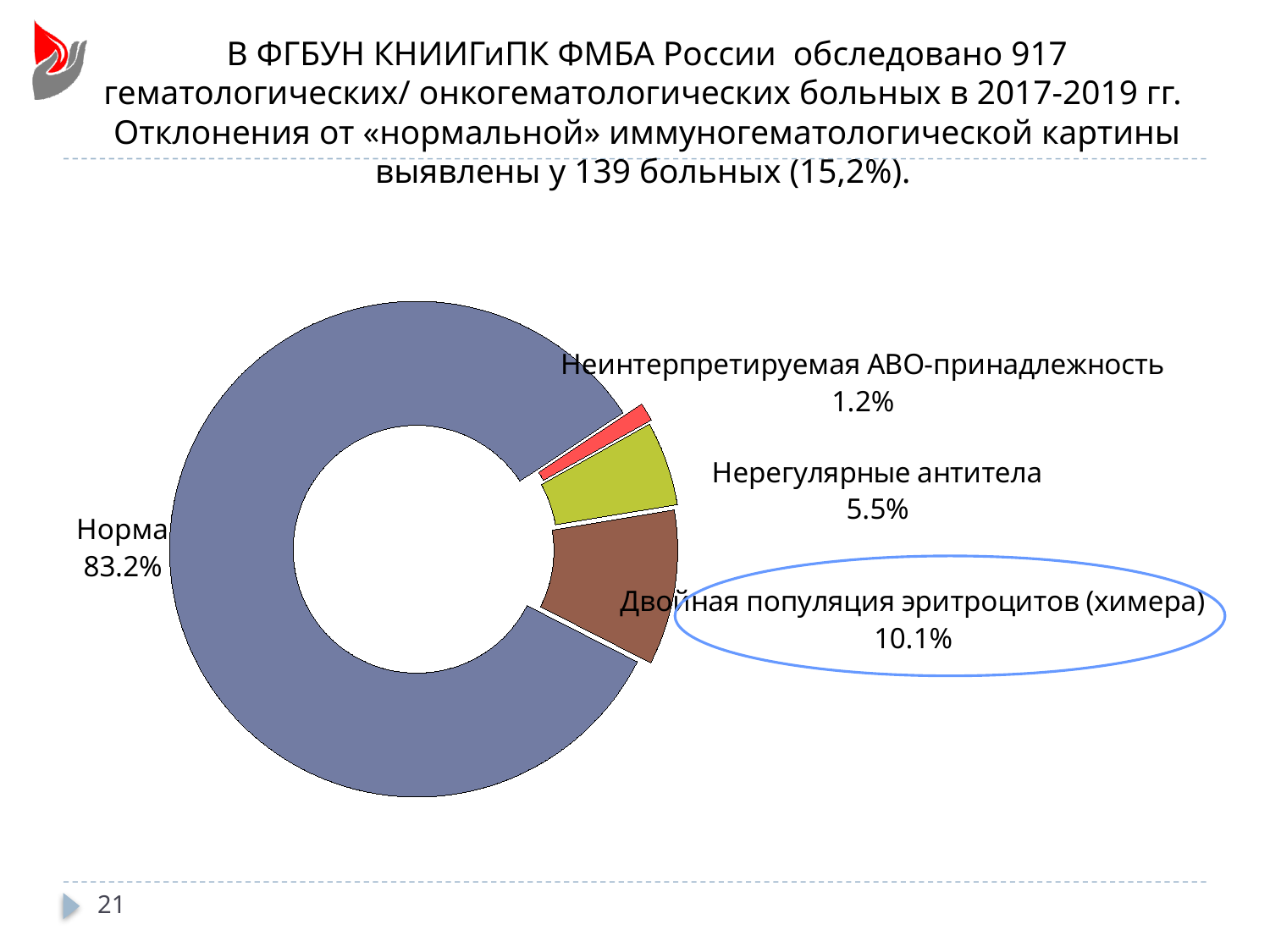
What is the difference between the values for Двойная популяция эритроцитов (химера) and Нерегулярные антитела? 4.6% Which category has the smallest slice in the chart? Неинтерпретируемая АВО-принадлежность What is the value shown for Двойная популяция эритроцитов (химера)? 10.1% Which category label on the chart is circled with a blue oval? Двойная популяция эритроцитов (химера) How many categories are shown in the chart? 4 What is the combined share of the three non-Норма categories? 16.8% What kind of chart is shown on the slide? Doughnut chart What is the value shown for Неинтерпретируемая АВО-принадлежность? 1.2% Which category has the largest slice in the chart? Норма What is the value shown for Нерегулярные антитела? 5.5% Which is larger: the slice for Нерегулярные антитела or the slice for Двойная популяция эритроцитов (химера)? Двойная популяция эритроцитов (химера) What share of the chart does the Норма slice represent? 83.2%